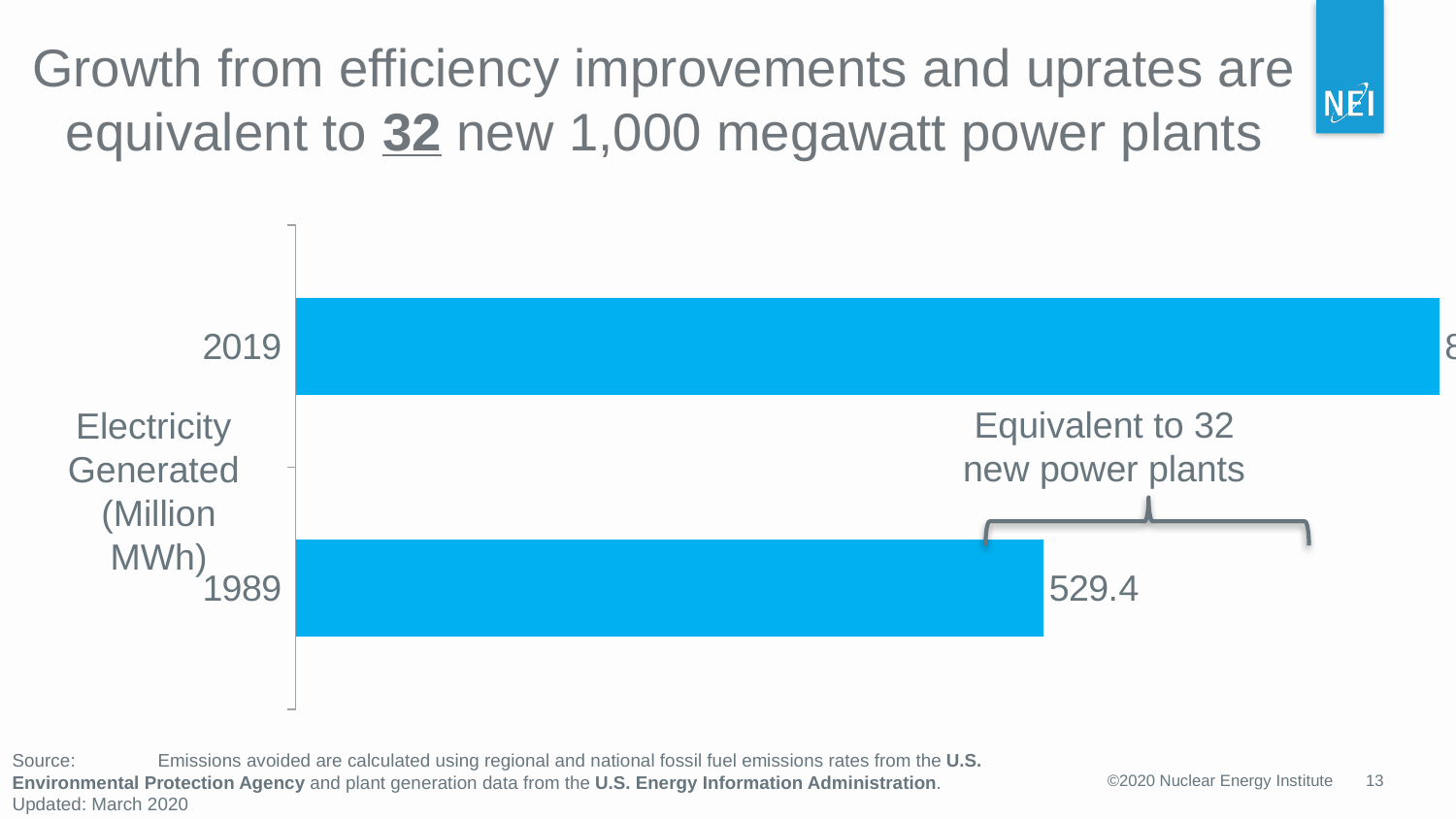
What kind of chart is shown on the slide? bar chart Which two years are compared in the chart? 1989 and 2019 What unit is given for the electricity generated axis label? Million MWh Which year has the shorter bar in the chart? 1989 What is the value for 1989 in the Electricity Generated chart? 529.4 According to the annotation on the chart, the growth between 1989 and 2019 is equivalent to how many new power plants? 32 How many bars are plotted in the chart? 2 Which year has the longer bar in the chart? 2019 Is the bar for 2019 longer or shorter than the bar for 1989? longer